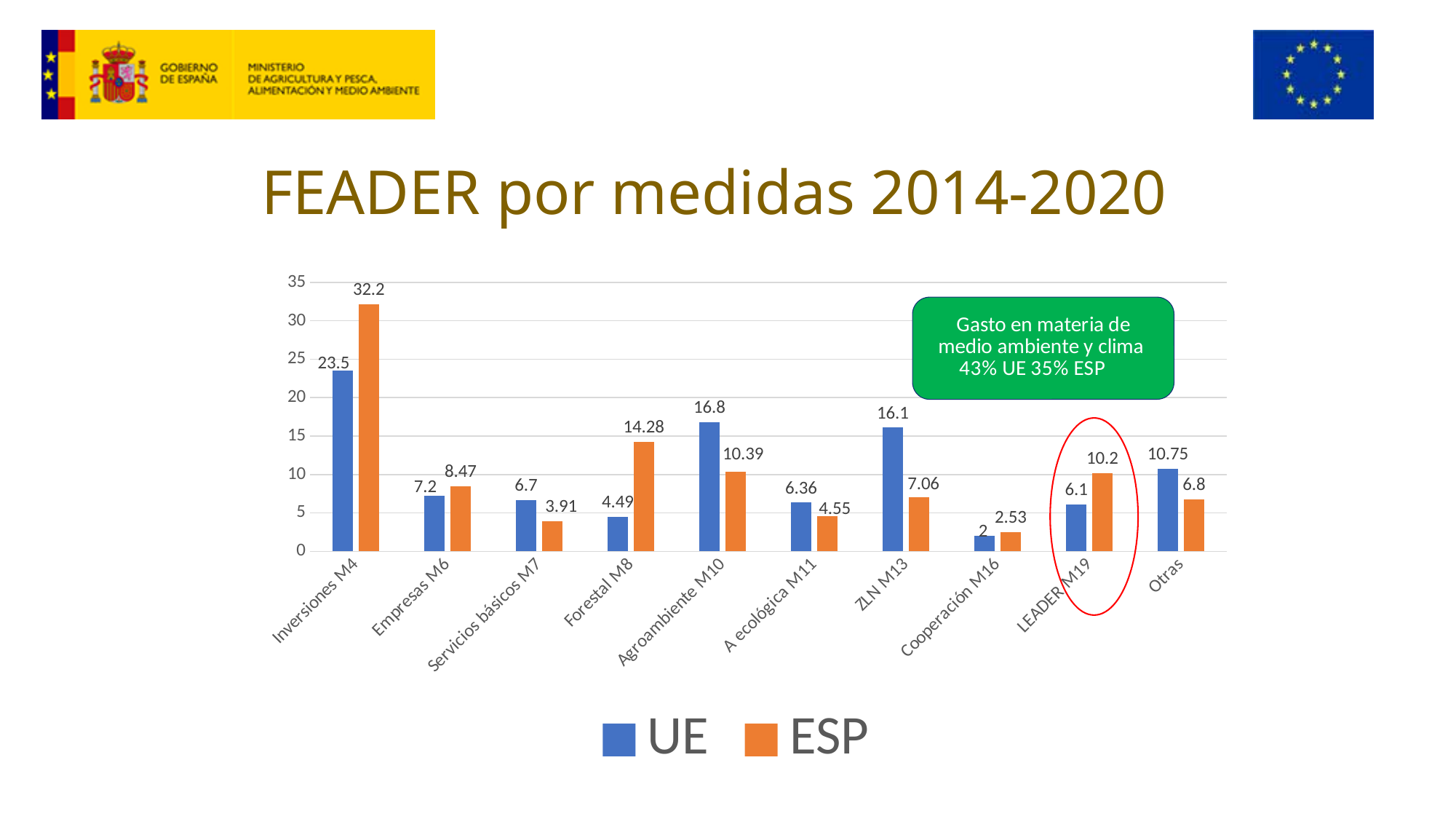
What is the ESP value for LEADER M19? 10.2 What is the difference between the ESP and UE values for Inversiones M4? 8.7 What is the UE value for Inversiones M4? 23.5 How many series does the legend list? 2 Which category has the lowest UE value? Cooperación M16 Which category has the highest ESP value? Inversiones M4 For Agroambiente M10, which is larger, the UE value or the ESP value? UE What is the ESP value for Forestal M8? 14.28 How many categories are shown on the x axis? 10 What is the title of the chart? FEADER por medidas 2014-2020 Is the UE value for ZLN M13 greater or less than 15? greater What kind of chart is shown on the slide? Bar chart